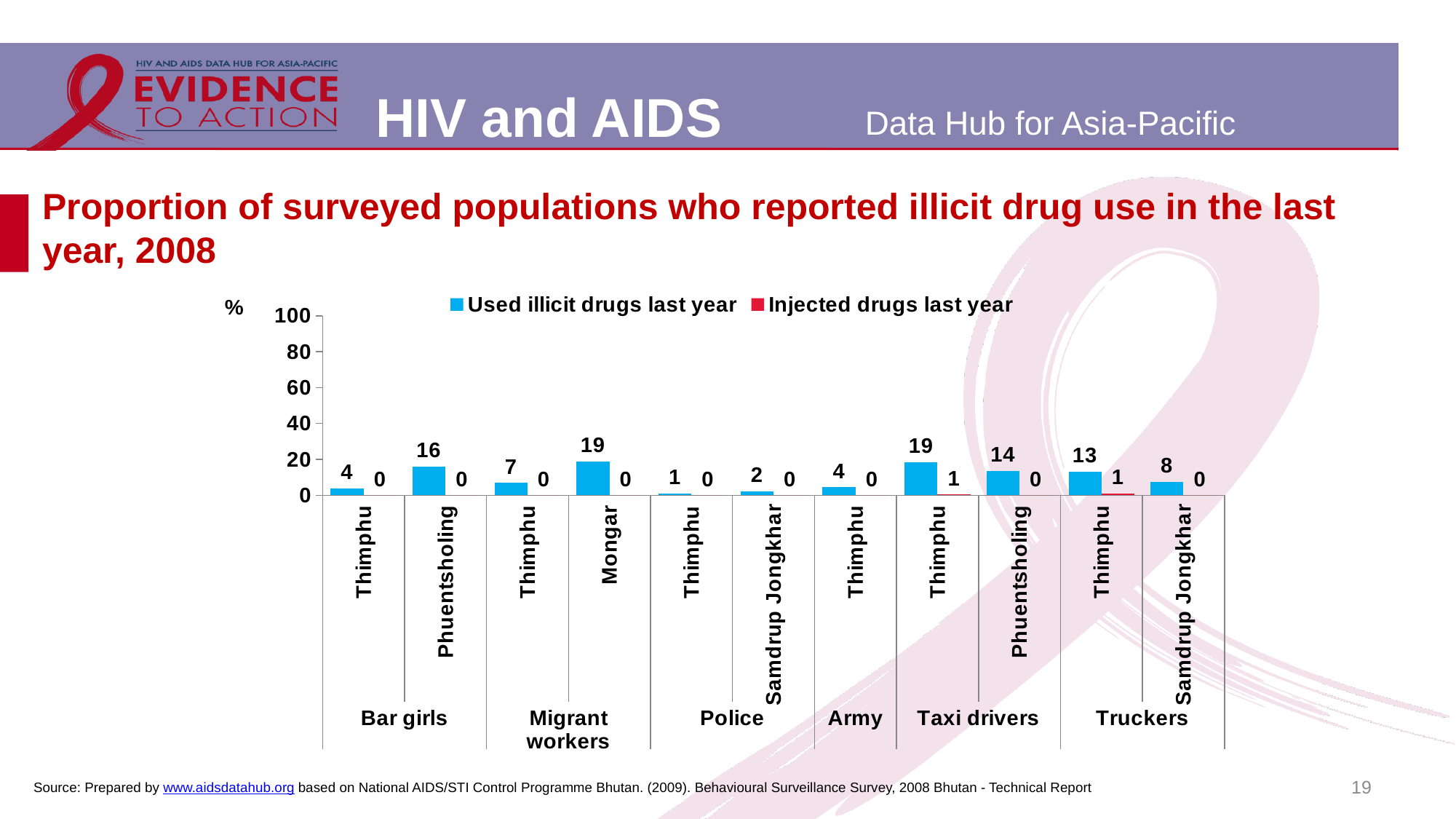
What percentage of bar girls in Phuentsholing reported using illicit drugs in the last year? 16 Which has a higher 'Used illicit drugs last year' value: truckers in Thimphu or truckers in Samdrup Jongkhar? Truckers in Thimphu What colour represents the 'Injected drugs last year' series? Red What percentage of truckers in Samdrup Jongkhar reported using illicit drugs in the last year? 8 What type of chart is shown on the slide? Bar chart What is the value for 'Injected drugs last year' among taxi drivers in Thimphu? 1 What is the difference between the 'Used illicit drugs last year' values for bar girls in Phuentsholing and bar girls in Thimphu? 12 How many location bars (category groups) are plotted along the x axis? 11 What is the value for 'Used illicit drugs last year' among migrant workers in Mongar? 19 How many series does the legend list? 2 Which group and location has the lowest value for 'Used illicit drugs last year'? Police, Thimphu Is the 'Used illicit drugs last year' value for taxi drivers in Phuentsholing greater or less than 20? less